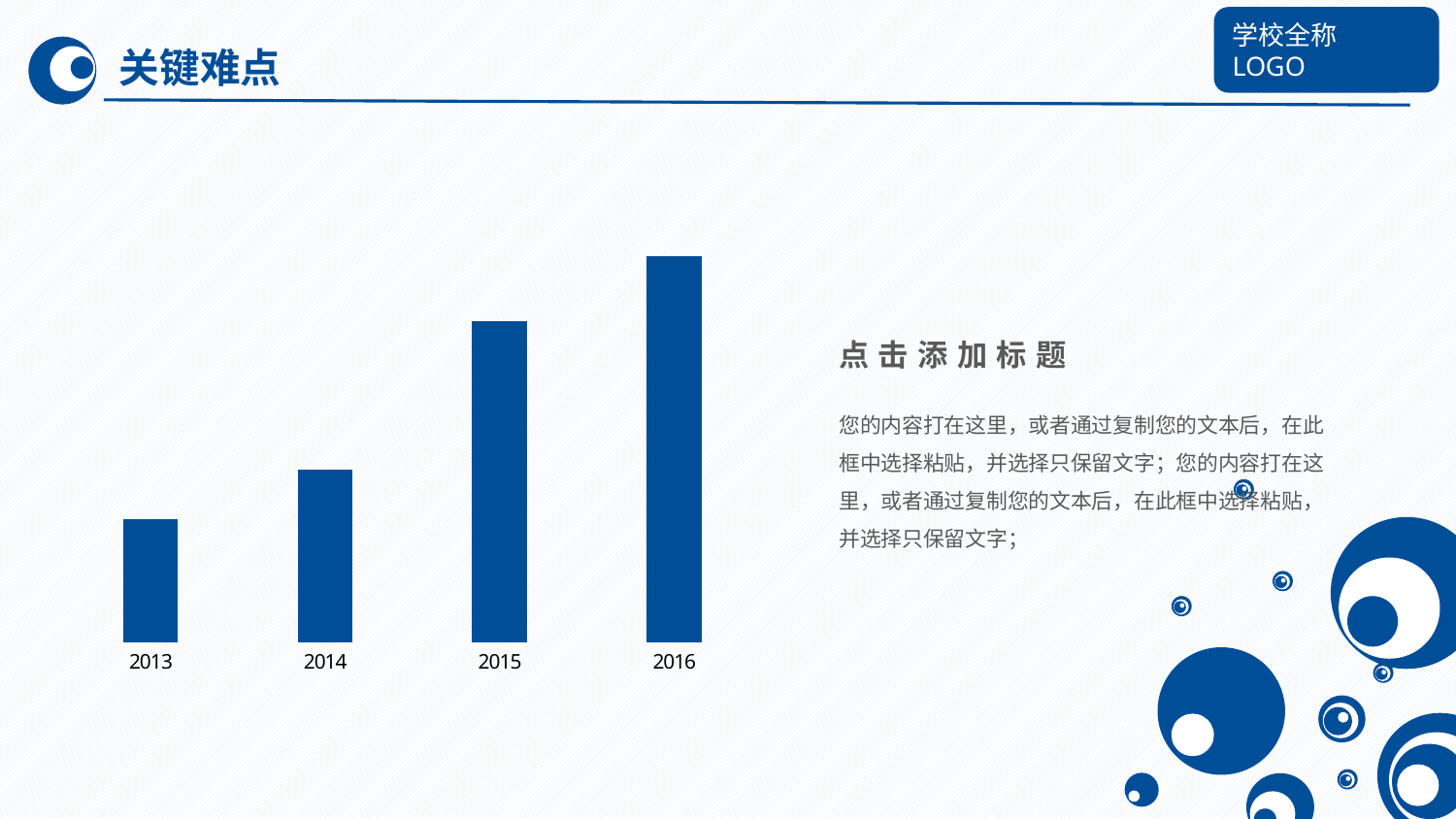
What kind of chart is shown on the slide? bar chart Which bar is taller, 2013 or 2014? 2014 Which year has the tallest bar in the chart? 2016 Do the bar values rise or fall from 2013 to 2016? rise Which bar is taller, 2014 or 2015? 2015 What is the first year shown on the x axis of the chart? 2013 How many categories (years) are shown on the x axis of the chart? 4 What colour are the bars in the chart? dark blue Which year has the shortest bar in the chart? 2013